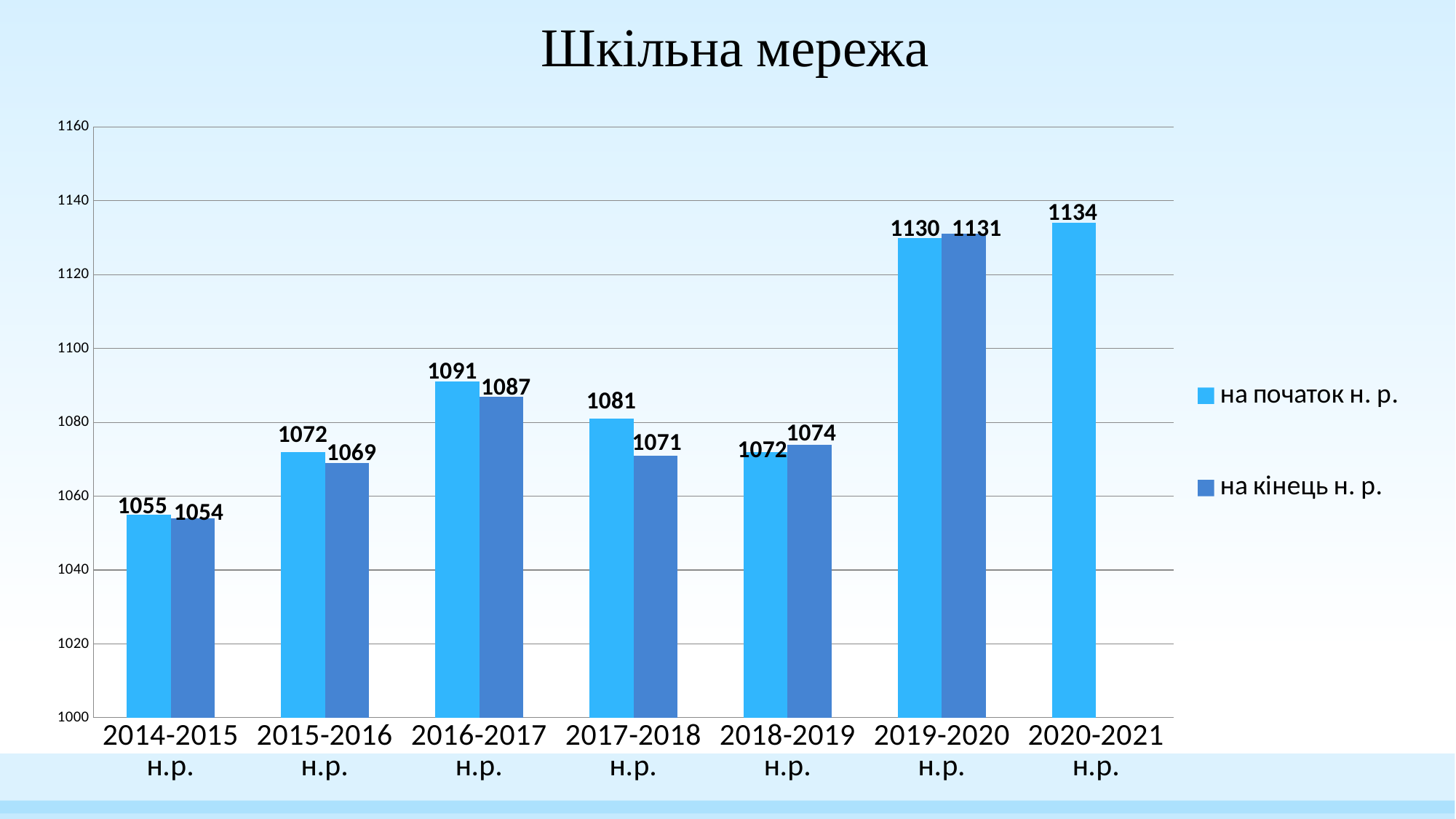
What is the difference between the "на початок н. р." and "на кінець н. р." values in 2017-2018 н.р.? 10 How many school years are shown on the x axis? 7 Is the value for "на кінець н. р." in 2019-2020 н.р. greater or less than 1120? greater What kind of chart is shown on the slide? bar chart What is the title of the chart? Шкільна мережа Which school year has the highest value for "на початок н. р."? 2020-2021 н.р. How many series does the legend list? 2 What is the value for "на початок н. р." in 2014-2015 н.р.? 1055 What is the value for "на кінець н. р." in 2017-2018 н.р.? 1071 What is the value for "на початок н. р." in 2020-2021 н.р.? 1134 Which school year has the lowest value for "на кінець н. р."? 2014-2015 н.р. Which is larger in 2016-2017 н.р.: the "на початок н. р." value or the "на кінець н. р." value? на початок н. р.